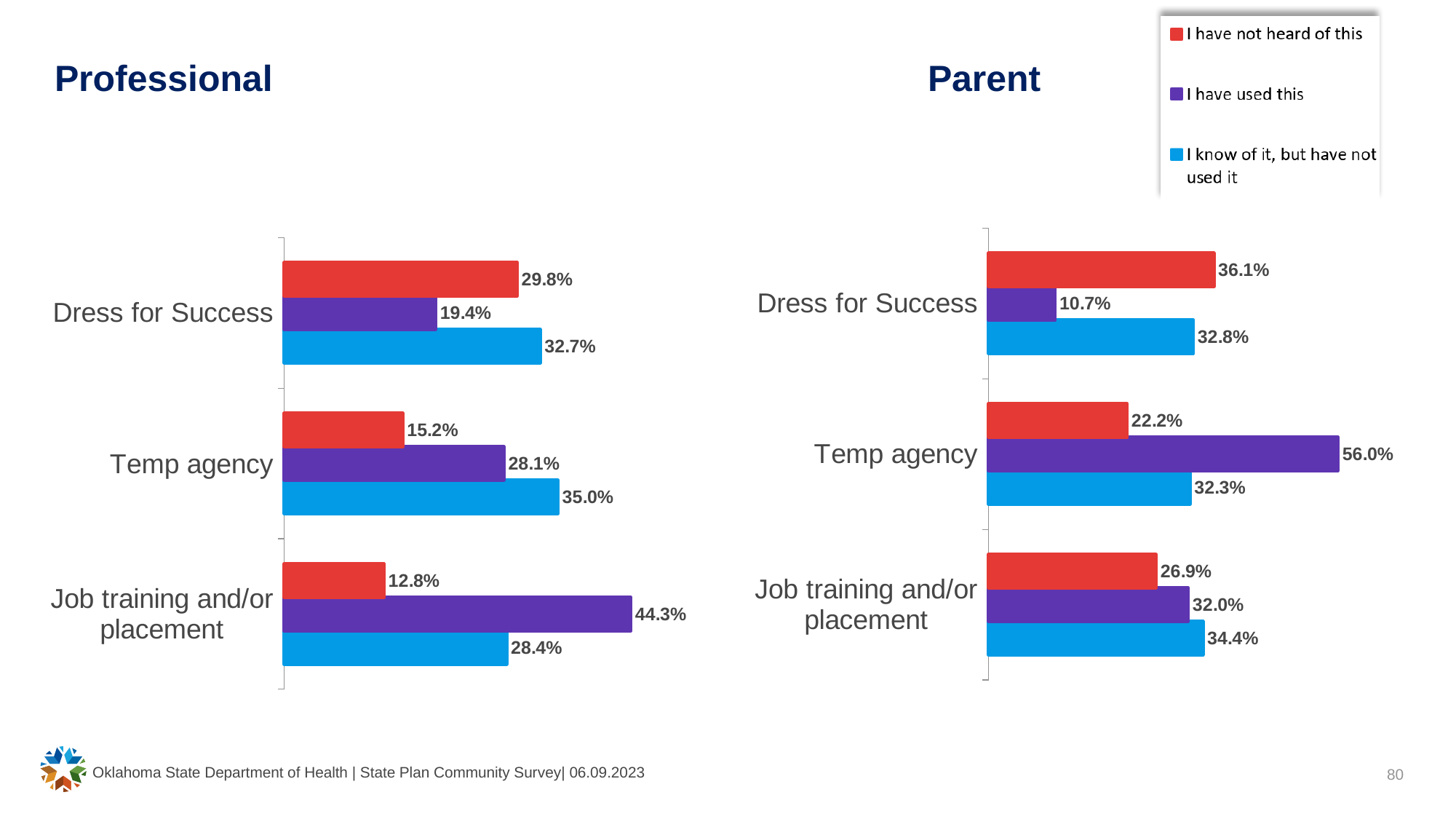
How many series does the legend list? 3 In the Parent chart, what is the value for 'I know of it, but have not used it' for Temp agency? 32.3% In the Professional chart, which category has the lowest value for 'I have not heard of this'? Job training and/or placement In the Parent chart, which category has the highest value for 'I have used this'? Temp agency In the Professional chart, what is the difference between 'I know of it, but have not used it' and 'I have used this' for Dress for Success? 13.3% What kind of chart is the Professional chart? Bar chart In the Professional chart, what is the value for 'I have not heard of this' for Temp agency? 15.2% In the Parent chart, what is the value for 'I have not heard of this' for Dress for Success? 36.1% How many categories are shown in the Parent chart? 3 Which is larger: the Professional chart's 'I have used this' value for Job training and/or placement, or the Parent chart's 'I have used this' value for Job training and/or placement? Professional (44.3%) In the Professional chart, what is the value for 'I have used this' for Job training and/or placement? 44.3% In the Parent chart, what is the difference between 'I have used this' and 'I have not heard of this' for Temp agency? 33.8%